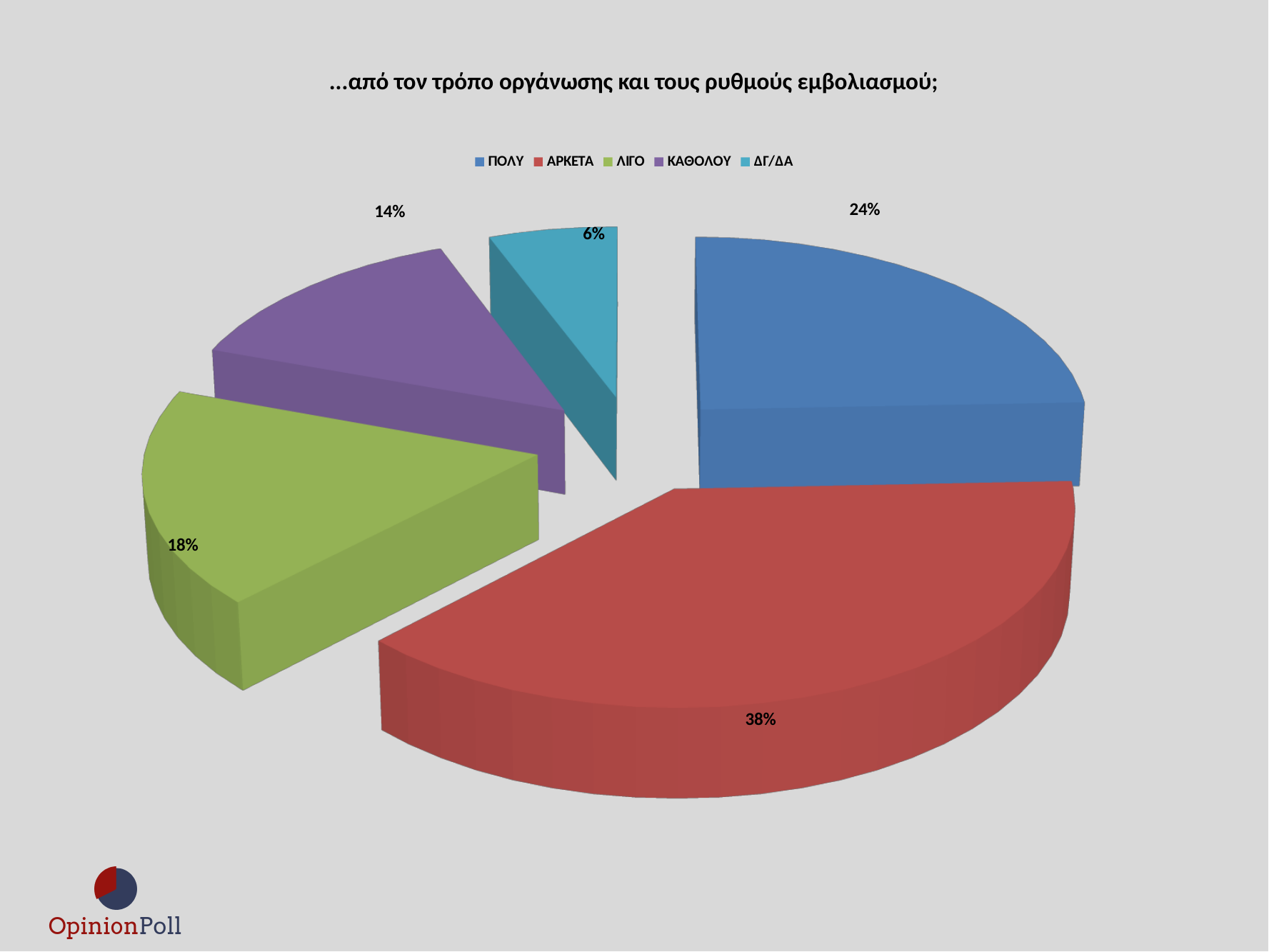
What colour is the slice for ΑΡΚΕΤΑ? red How many categories does the legend list? 5 What percentage is shown for ΑΡΚΕΤΑ? 38% What percentage is shown for ΠΟΛΥ? 24% What percentage is shown for ΛΙΓΟ? 18% Which is larger, the share for ΛΙΓΟ or the share for ΚΑΘΟΛΟΥ? ΛΙΓΟ What percentage is shown for ΔΓ/ΔΑ? 6% Which category has the largest share of the pie? ΑΡΚΕΤΑ What type of chart is shown on the slide? pie chart What is the difference in percentage points between ΑΡΚΕΤΑ and ΠΟΛΥ? 14 Which category has the smallest share of the pie? ΔΓ/ΔΑ What percentage is shown for ΚΑΘΟΛΟΥ? 14%